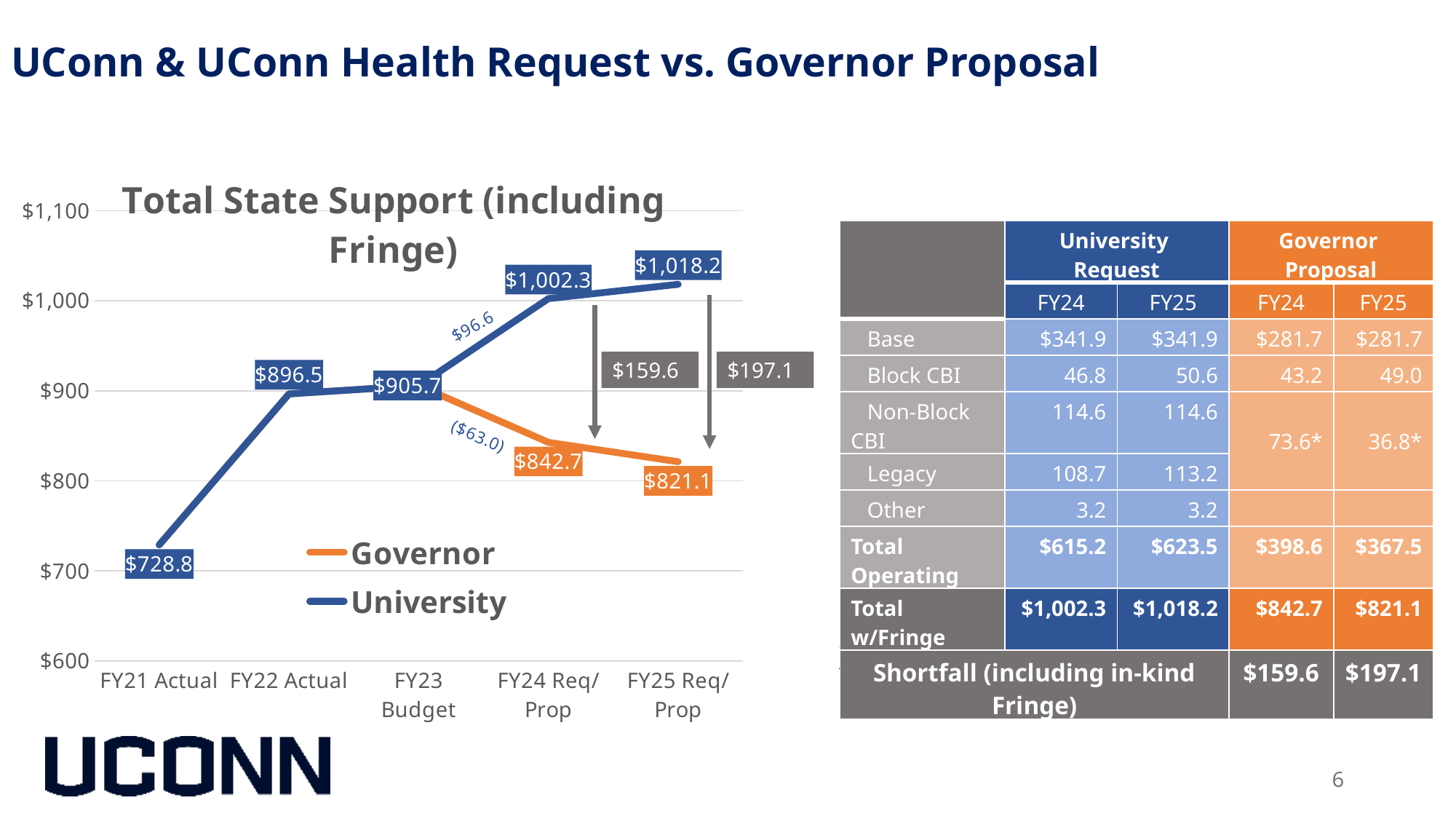
What is the value for FY21 Actual in the chart? $728.8 What is the value for FY23 Budget? $905.7 What is the University value for FY25 Req/Prop? $1,018.2 How many series does the chart legend list? 2 Which is larger for FY24 Req/Prop, the University value or the Governor value? University How many categories are shown on the x axis of the chart? 5 What is the difference between the University and Governor values for FY25 Req/Prop? $197.1 What kind of chart is shown on the slide? line chart Does the Governor series rise or fall from FY24 Req/Prop to FY25 Req/Prop? fall Which category has the lowest value on the chart? FY21 Actual What is the title of the chart? Total State Support (including Fringe) What is the Governor value for FY24 Req/Prop? $842.7